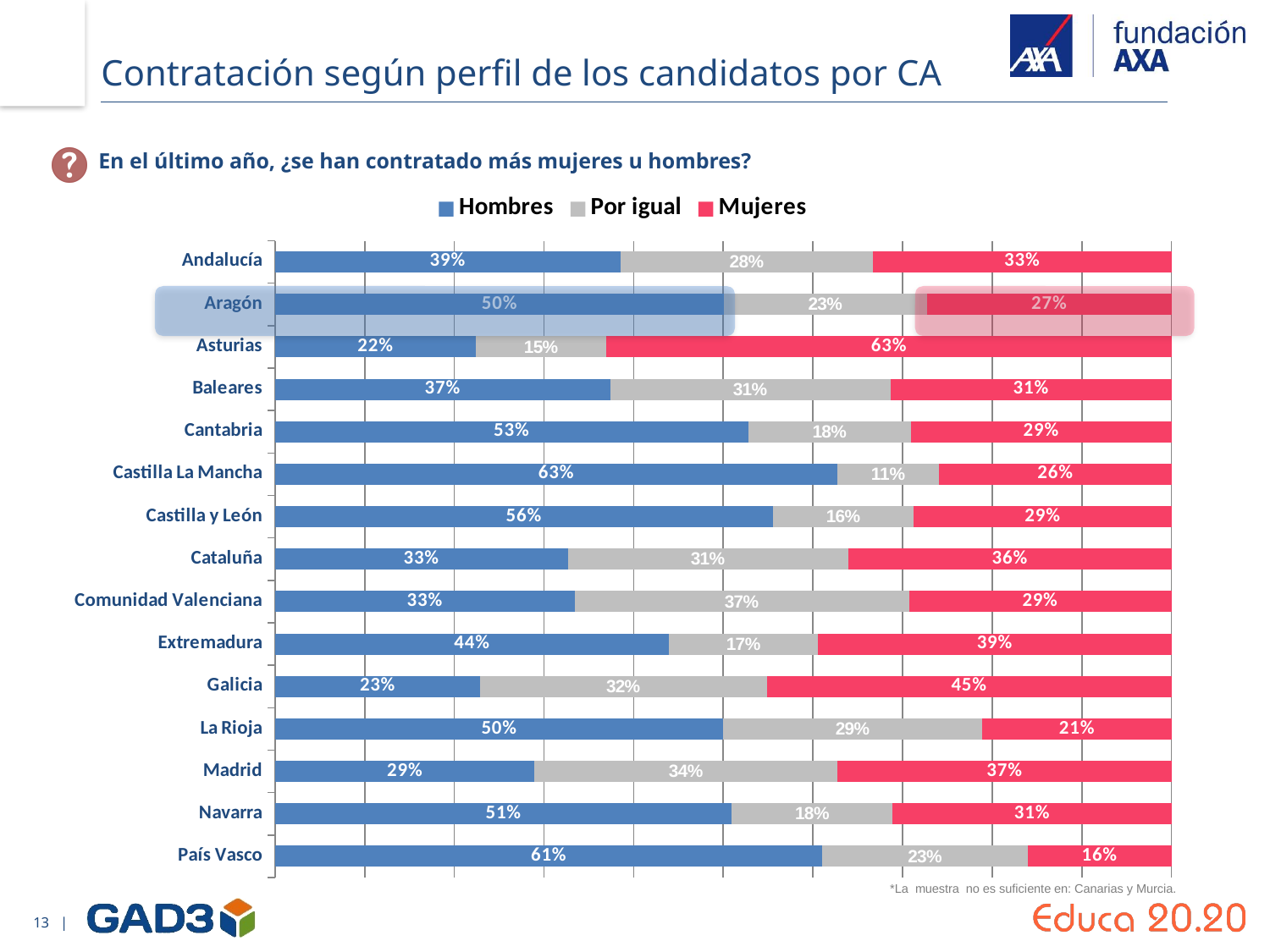
Which region has the lowest Hombres value? Asturias What is the Hombres value for Castilla y León? 56% Which region has the highest Hombres value? Castilla La Mancha What is the total of the three segments for Andalucía? 100% Which is larger for Madrid, the Hombres value or the Mujeres value? Mujeres What kind of chart is shown on the slide? Stacked bar chart What is the difference between the Hombres and Mujeres values for Galicia? 22% How many series does the legend list? 3 What is the Por igual value for Comunidad Valenciana? 37% Which region has the lowest Mujeres value? País Vasco What percentage of respondents in Asturias said more women (Mujeres) were hired? 63% How many regions (categories) are shown in the chart? 15